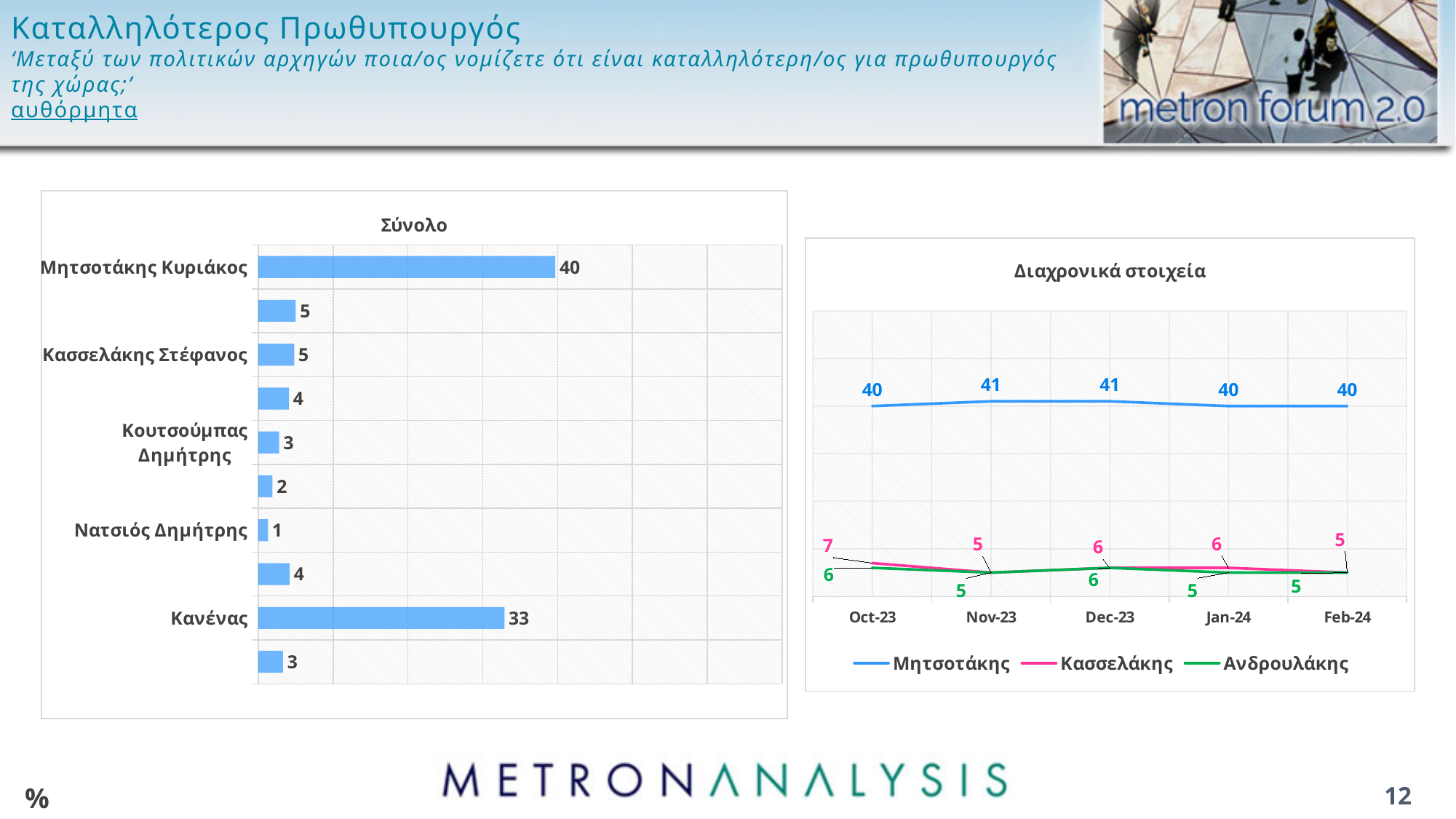
In the 'Σύνολο' chart, which is larger, the value for Κασσελάκης Στέφανος or the value for Νατσιός Δημήτρης? Κασσελάκης Στέφανος In the 'Διαχρονικά στοιχεία' chart, what is the value for Μητσοτάκης in Nov-23? 41 In the 'Σύνολο' chart, which labelled category has the highest value? Μητσοτάκης Κυριάκος In the 'Σύνολο' chart, what is the value for Κουτσούμπας Δημήτρης? 3 In the 'Σύνολο' chart, what is the difference between the values for Μητσοτάκης Κυριάκος and Κανένας? 7 In the 'Σύνολο' chart, what is the value for Νατσιός Δημήτρης? 1 In the 'Σύνολο' chart, what is the value for Κανένας? 33 What kind of chart is the 'Σύνολο' chart? Bar chart How many series does the legend of the 'Διαχρονικά στοιχεία' chart list? 3 How many time points are shown on the x axis of the 'Διαχρονικά στοιχεία' chart? 5 In the 'Σύνολο' chart, what is the value for Μητσοτάκης Κυριάκος? 40 In the 'Διαχρονικά στοιχεία' chart, what is the value for Κασσελάκης in Oct-23? 7